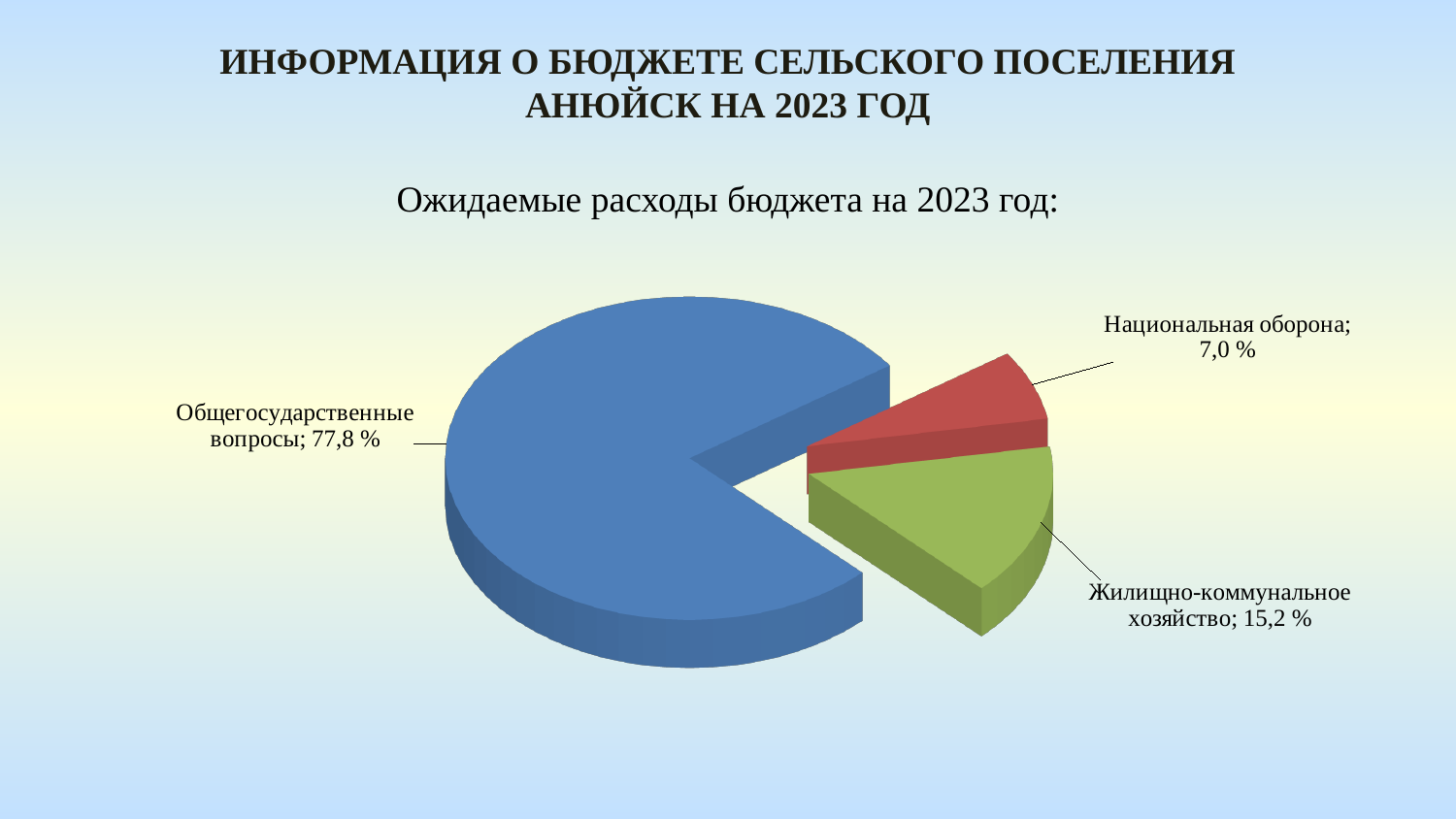
What share of expected 2023 budget expenditures goes to Общегосударственные вопросы? 77,8 % Which expenditure category has the smallest share of the pie? Национальная оборона What kind of chart is shown on the slide? Pie chart What colour is the slice for Национальная оборона? Red How many expenditure categories are shown in the pie chart? 3 What is the heading above the chart? Ожидаемые расходы бюджета на 2023 год: Which is larger: the share for Жилищно-коммунальное хозяйство or for Национальная оборона? Жилищно-коммунальное хозяйство What is the difference in percentage points between Общегосударственные вопросы and Жилищно-коммунальное хозяйство? 62,6 What share of expected 2023 budget expenditures goes to Национальная оборона? 7,0 % What is the difference in percentage points between Жилищно-коммунальное хозяйство and Национальная оборона? 8,2 Which expenditure category has the largest share of the pie? Общегосударственные вопросы What share of expected 2023 budget expenditures goes to Жилищно-коммунальное хозяйство? 15,2 %